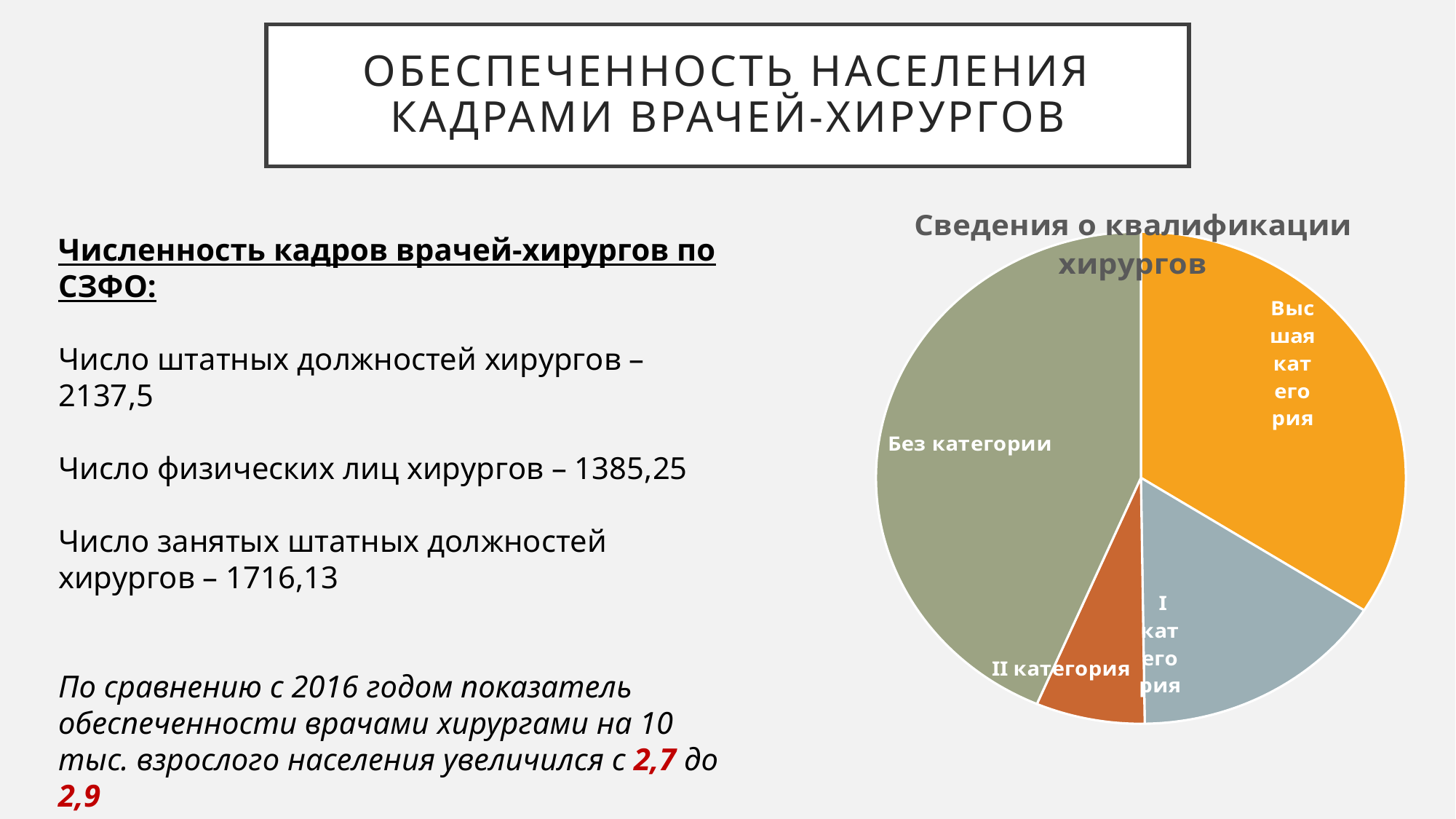
Which category has the largest slice in the pie chart? Без категории How many slices does the pie chart have? 4 Which category has the smallest slice in the pie chart? II категория What colour is the slice for Высшая категория? Orange Which slice is larger: II категория or Без категории? Без категории Which slice is larger: I категория or II категория? I категория Which category is the second-largest slice in the pie chart? Высшая категория What is the title of the pie chart? Сведения о квалификации хирургов Which slice is larger: Без категории or Высшая категория? Без категории What kind of chart is shown on the slide? Pie chart